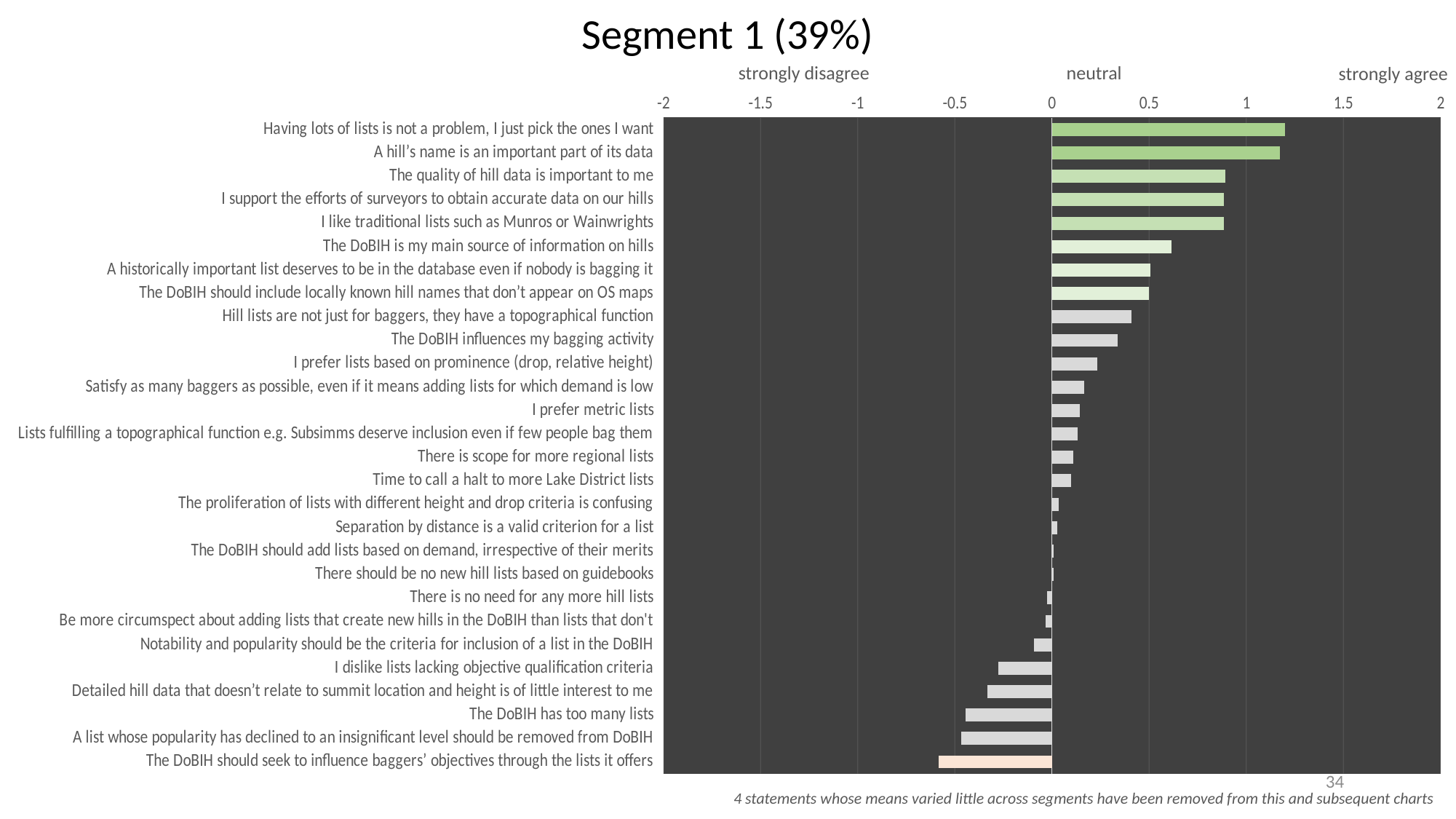
Which statement has the lowest value? The DoBIH should seek to influence baggers' objectives through the lists it offers Is the value for "The DoBIH has too many lists" greater or less than -0.5? greater What label appears at the right end of the x axis? strongly agree How many statements are plotted on the chart? 28 Is the value for "The DoBIH should seek to influence baggers' objectives through the lists it offers" greater or less than -0.5? less Which statement has the highest value? Having lots of lists is not a problem, I just pick the ones I want Which has the larger value: "I dislike lists lacking objective qualification criteria" or "The quality of hill data is important to me"? The quality of hill data is important to me Which has the larger value: "The DoBIH influences my bagging activity" or "I prefer metric lists"? The DoBIH influences my bagging activity What is the title of the chart? Segment 1 (39%) Is the value for "The DoBIH is my main source of information on hills" greater or less than 0.5? greater What kind of chart is shown on the slide? bar chart